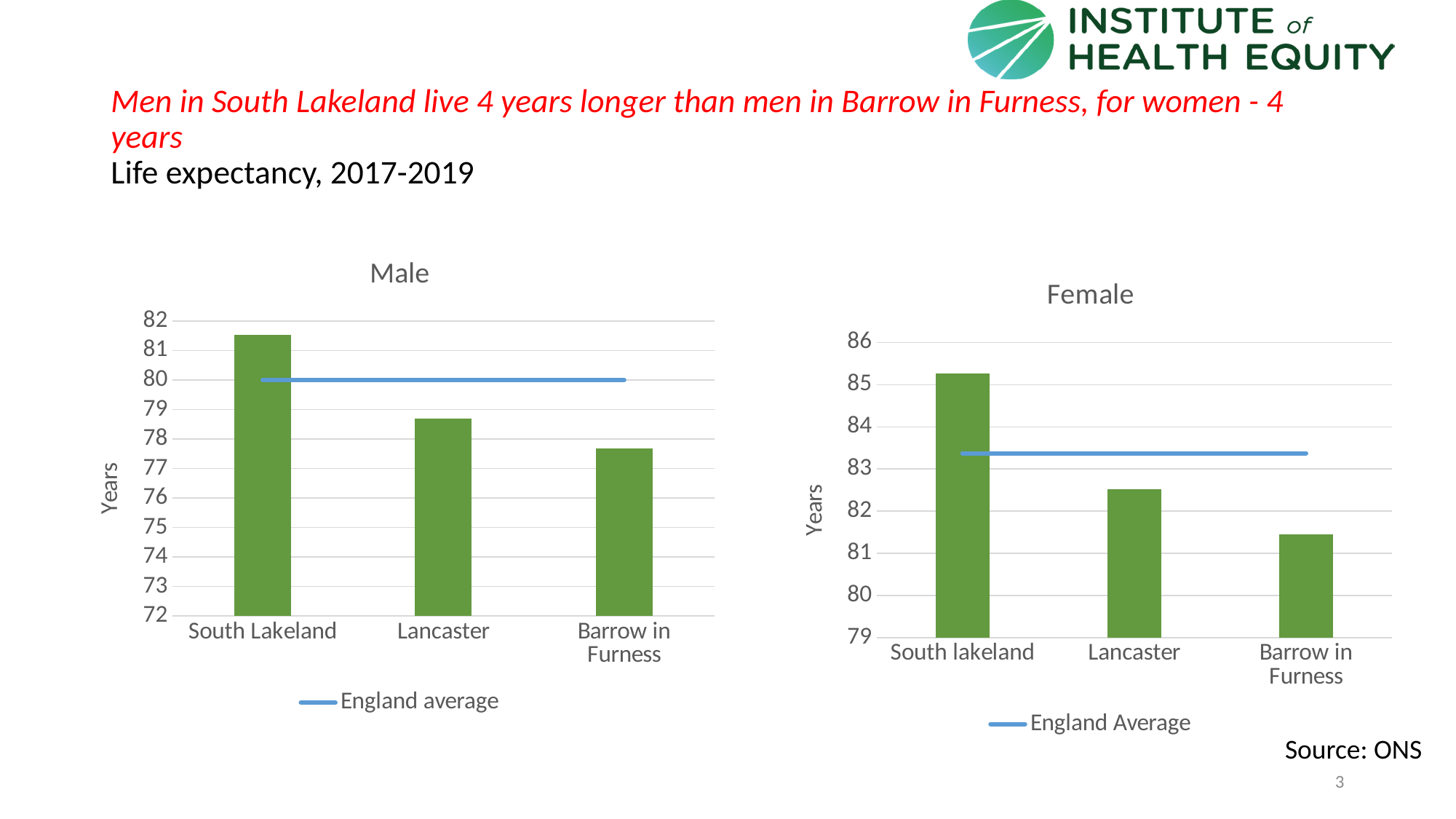
In the Male chart, what is the label on the vertical axis? Years In the Male chart, which area has the highest life expectancy? South Lakeland In the Male chart, how many areas are shown on the x axis? 3 In the Female chart, what does the legend say the blue line represents? England Average In the Male chart, which area has the lowest life expectancy? Barrow in Furness In the Female chart, which area has the highest life expectancy? South lakeland In the Female chart, do the bar values rise or fall from left to right across the areas? fall In the Male chart, is the value for Barrow in Furness greater or less than 78? less In the Male chart, is the value for Lancaster greater or less than the England average line? less In the Male chart, what kind of chart is used to show the life expectancy values? bar chart In the Female chart, is the value for Lancaster greater or less than 83? less In the Male chart, is the value for South Lakeland greater or less than 81? greater